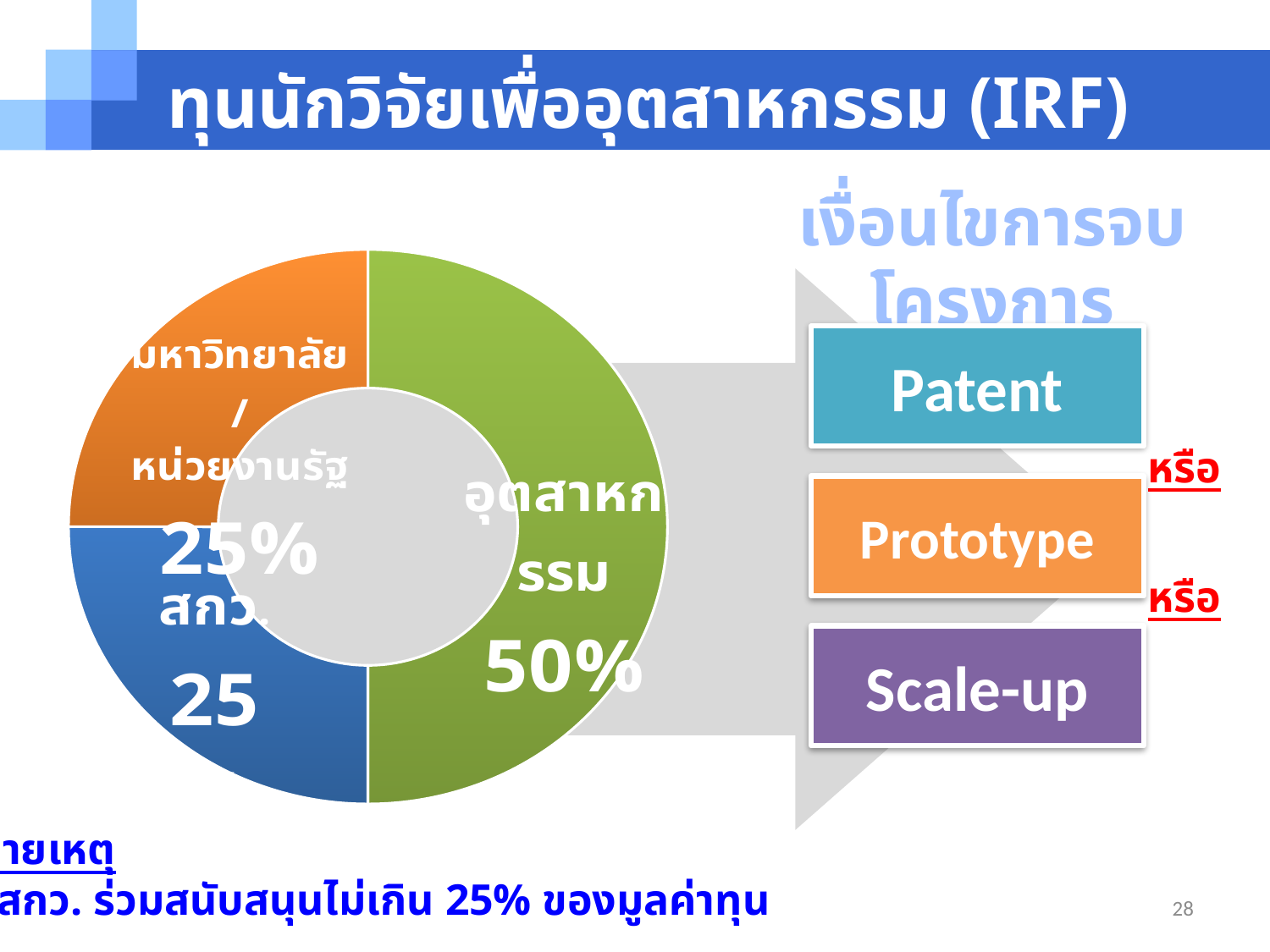
What colour is the อุตสาหกรรม segment of the doughnut chart? green Which is larger in the doughnut chart, อุตสาหกรรม or มหาวิทยาลัย/หน่วยงานรัฐ? อุตสาหกรรม Which segment of the doughnut chart is the largest? อุตสาหกรรม What is the title of the slide containing the doughnut chart? ทุนนักวิจัยเพื่ออุตสาหกรรม (IRF) What value is printed on the สกว. segment of the doughnut chart? 25 How many segments does the doughnut chart have? 3 What share of the doughnut chart is labelled อุตสาหกรรม? 50% What kind of chart is shown on the slide? doughnut (pie) chart What is the difference between the อุตสาหกรรม share and the มหาวิทยาลัย/หน่วยงานรัฐ share in the doughnut chart? 25% What value is shown for มหาวิทยาลัย/หน่วยงานรัฐ in the doughnut chart? 25%